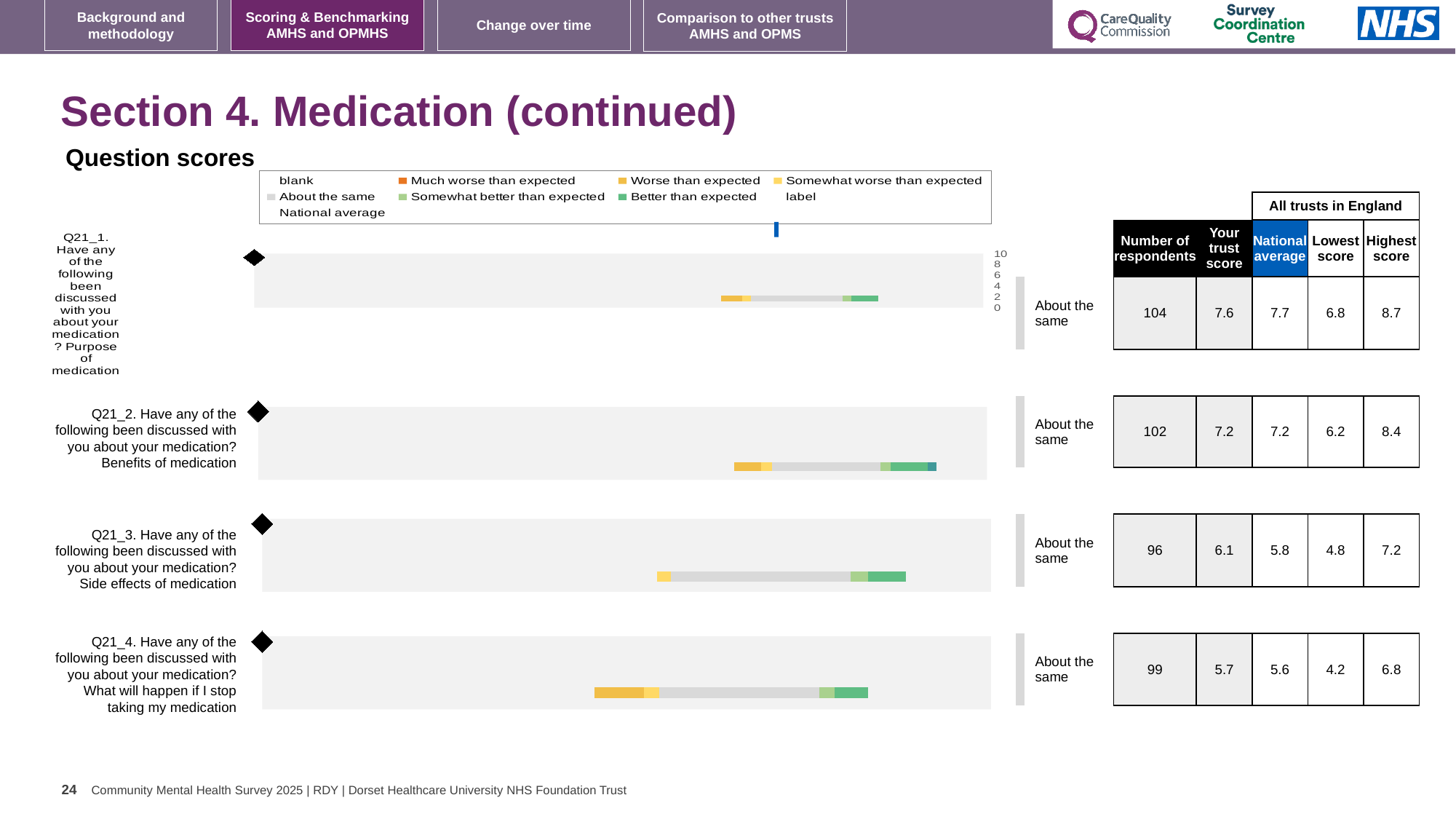
According to the table beside the charts, what is the trust score for Q21_1 (Purpose of medication)? 7.6 According to the table beside the charts, how many respondents answered Q21_4 (What will happen if I stop taking my medication)? 99 How many question-score charts (Q21_1 to Q21_4) are shown on the slide? 4 How many entries does the shared legend above the question-score charts list? 9 For Q21_2 (Benefits of medication), is the trust score or the national average larger, or are they equal? equal Which of the four questions (Q21_1 to Q21_4) has the lowest national average in the table beside the charts? Q21_4 For Q21_3 (Side effects of medication), what is the difference between the highest score and the lowest score across all trusts in England? 2.4 What colour does the legend assign to the 'Better than expected' category? green What kind of chart is used to show the question scores for Q21_1 to Q21_4? bar chart What benchmark label is shown next to the chart for Q21_4 (What will happen if I stop taking my medication)? About the same Which of the four questions (Q21_1 to Q21_4) has the highest trust score in the table beside the charts? Q21_1 According to the table beside the charts, what is the national average for Q21_3 (Side effects of medication)? 5.8